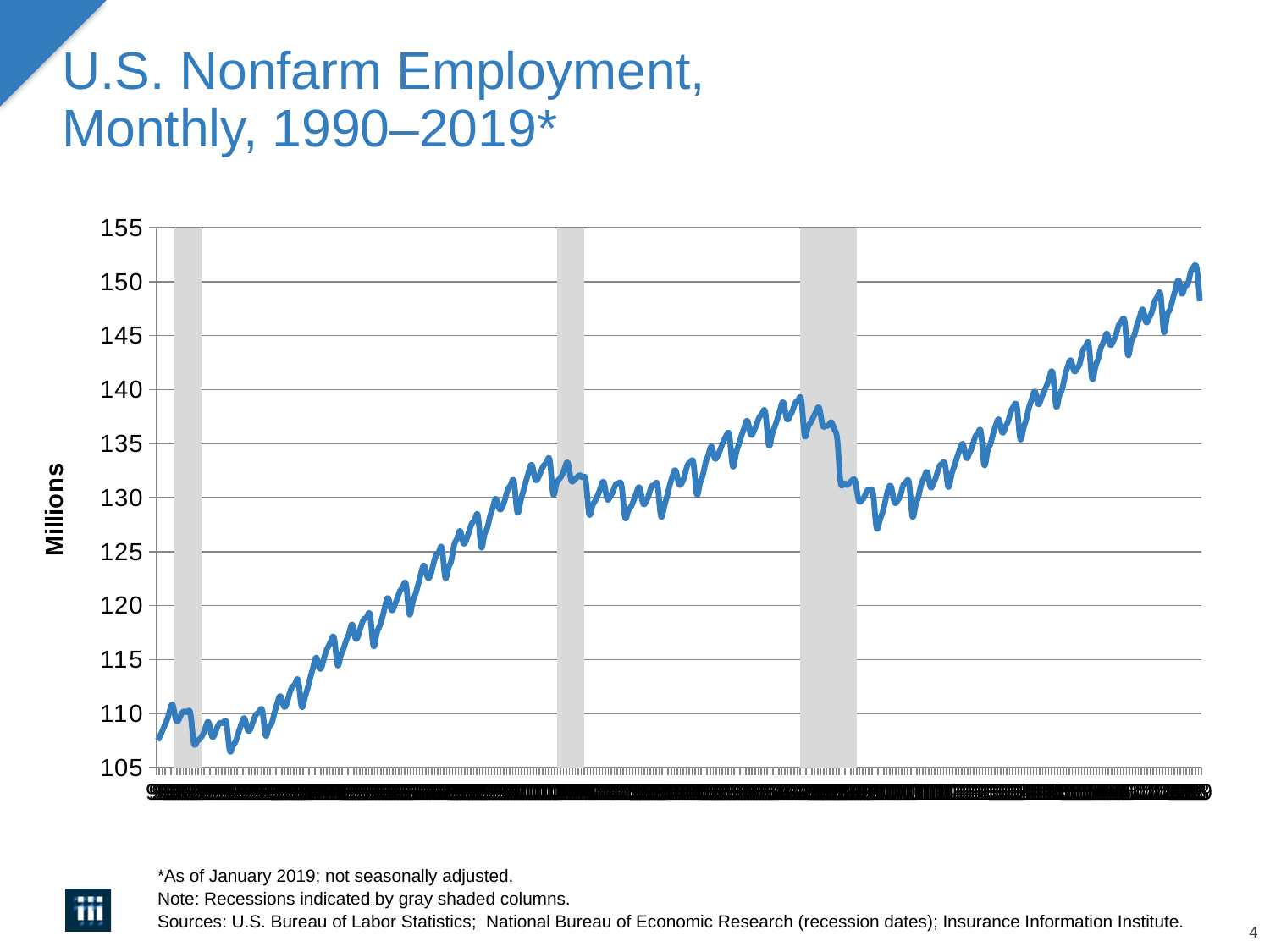
How many gray shaded recession columns are shown on the chart? 3 Is the value at the far right (end) of the line greater or less than 155? less Overall, does U.S. nonfarm employment rise or fall from the left of the chart to the right? Rise Is the value at the far right (end) of the line greater or less than the value at the far left (start)? greater Is the value at the far left (start) of the line greater or less than 105? greater Is the lowest value on the line greater or less than 110? less What type of chart is shown on the slide? Line chart What is the label on the vertical axis? Millions